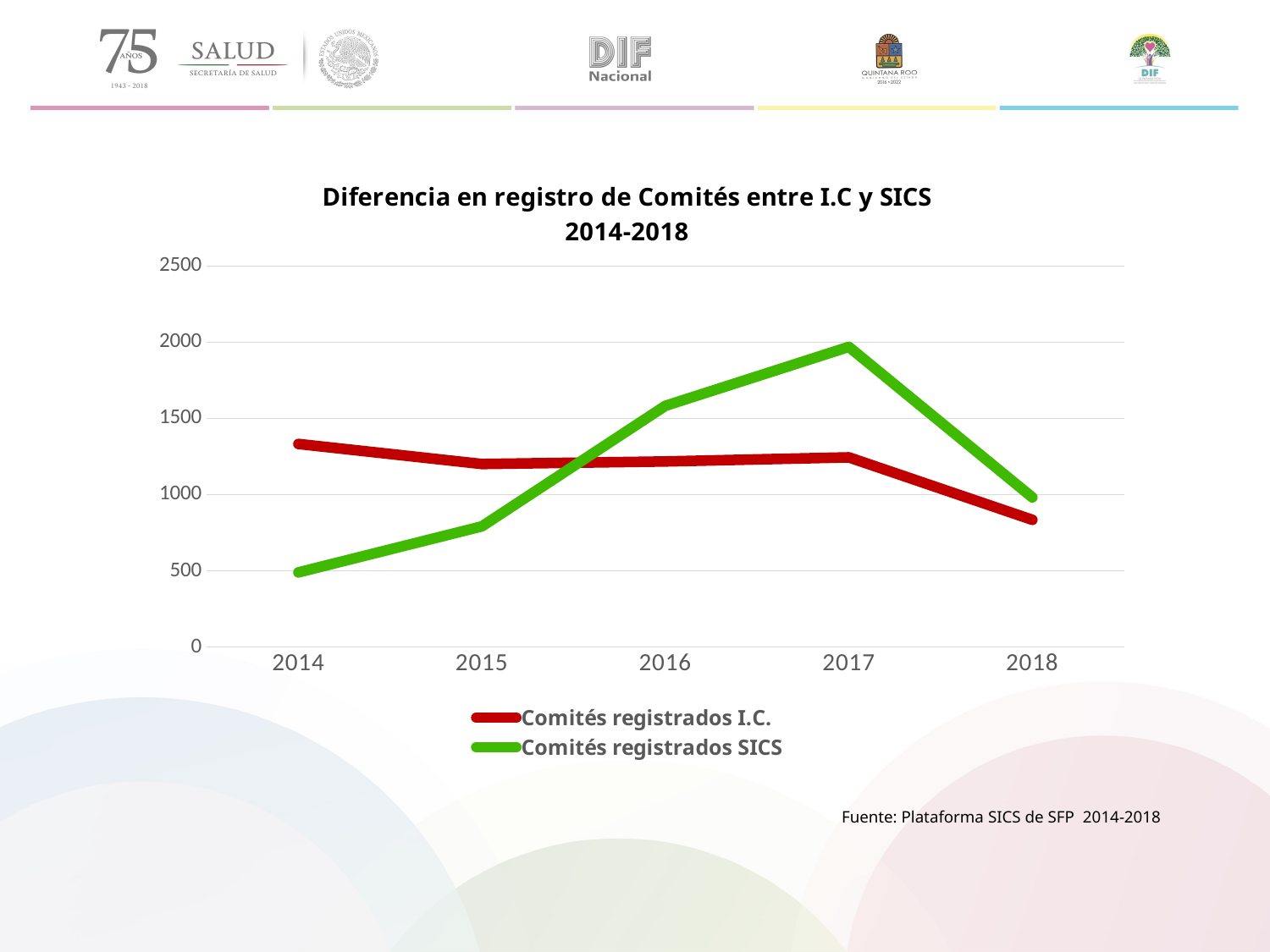
In which year does the Comités registrados I.C. series have its lowest value? 2018 What colour is the line for Comités registrados SICS? Green In which year does the Comités registrados SICS series have its lowest value? 2014 In 2014, which series has the larger value, Comités registrados I.C. or Comités registrados SICS? Comités registrados I.C. What kind of chart is shown on the slide? Line chart In which year does the Comités registrados SICS series reach its highest value? 2017 Is the value for Comités registrados SICS in 2017 greater or less than 1500? greater How many years are plotted along the x axis? 5 Is the value for Comités registrados I.C. in 2018 greater or less than 1000? less In 2017, which series has the larger value, Comités registrados I.C. or Comités registrados SICS? Comités registrados SICS How many series does the legend list? 2 Does the Comités registrados SICS series rise or fall from 2014 to 2017? rise